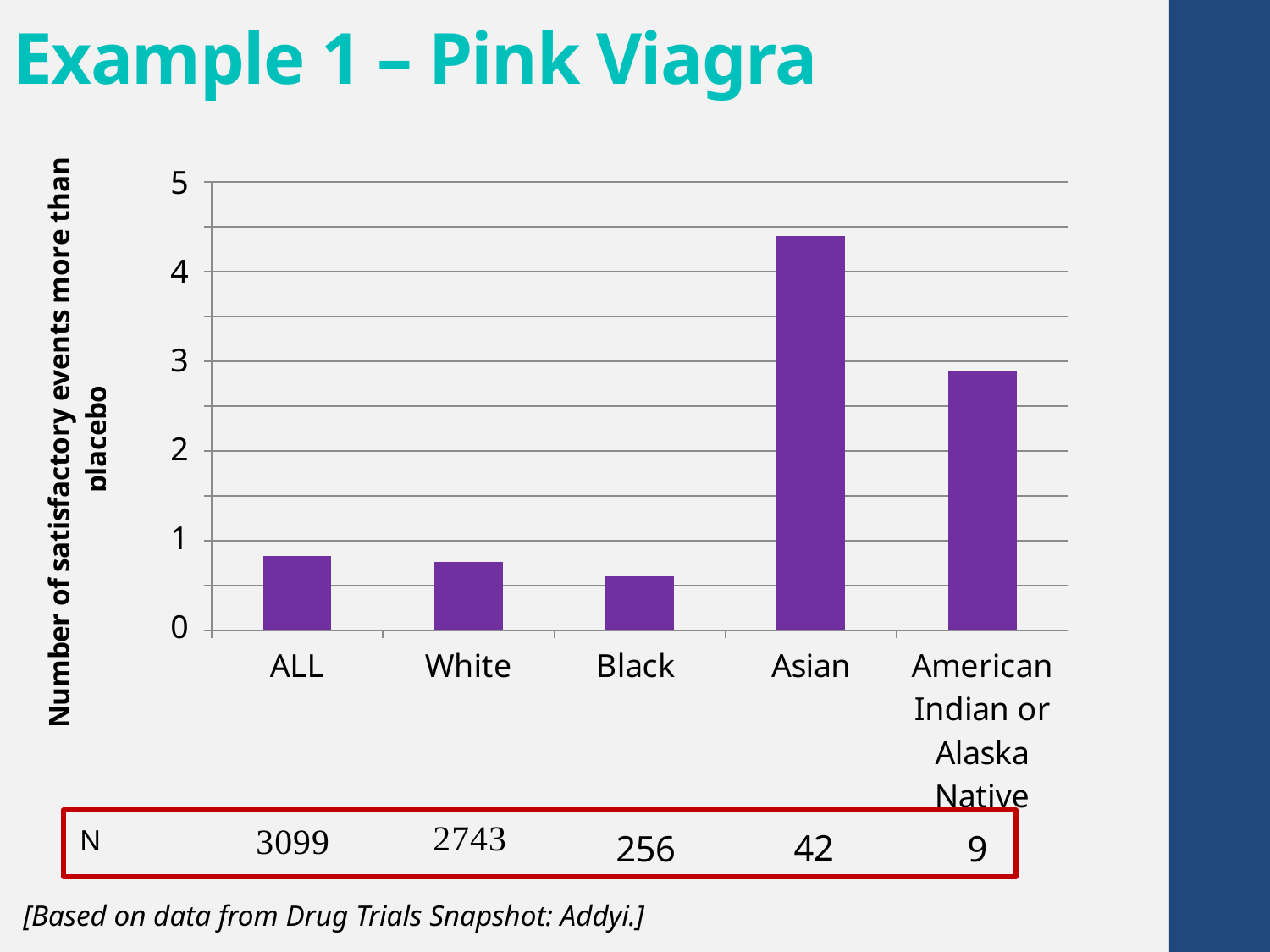
How many categories are shown on the x axis of the chart? 5 What is the N for the Asian group shown in the table below the chart? 42 Is the value for ALL greater or less than 1? less What kind of chart is shown on the slide? bar chart What is the label on the y axis of the chart? Number of satisfactory events more than placebo Which category has the lowest number of satisfactory events more than placebo? Black Is the value for Asian greater or less than 4? greater Which has a larger value, Asian or American Indian or Alaska Native? Asian Is the value for Black greater or less than 1? less What is the N for the White group shown in the table below the chart? 2743 Which category has the highest number of satisfactory events more than placebo? Asian